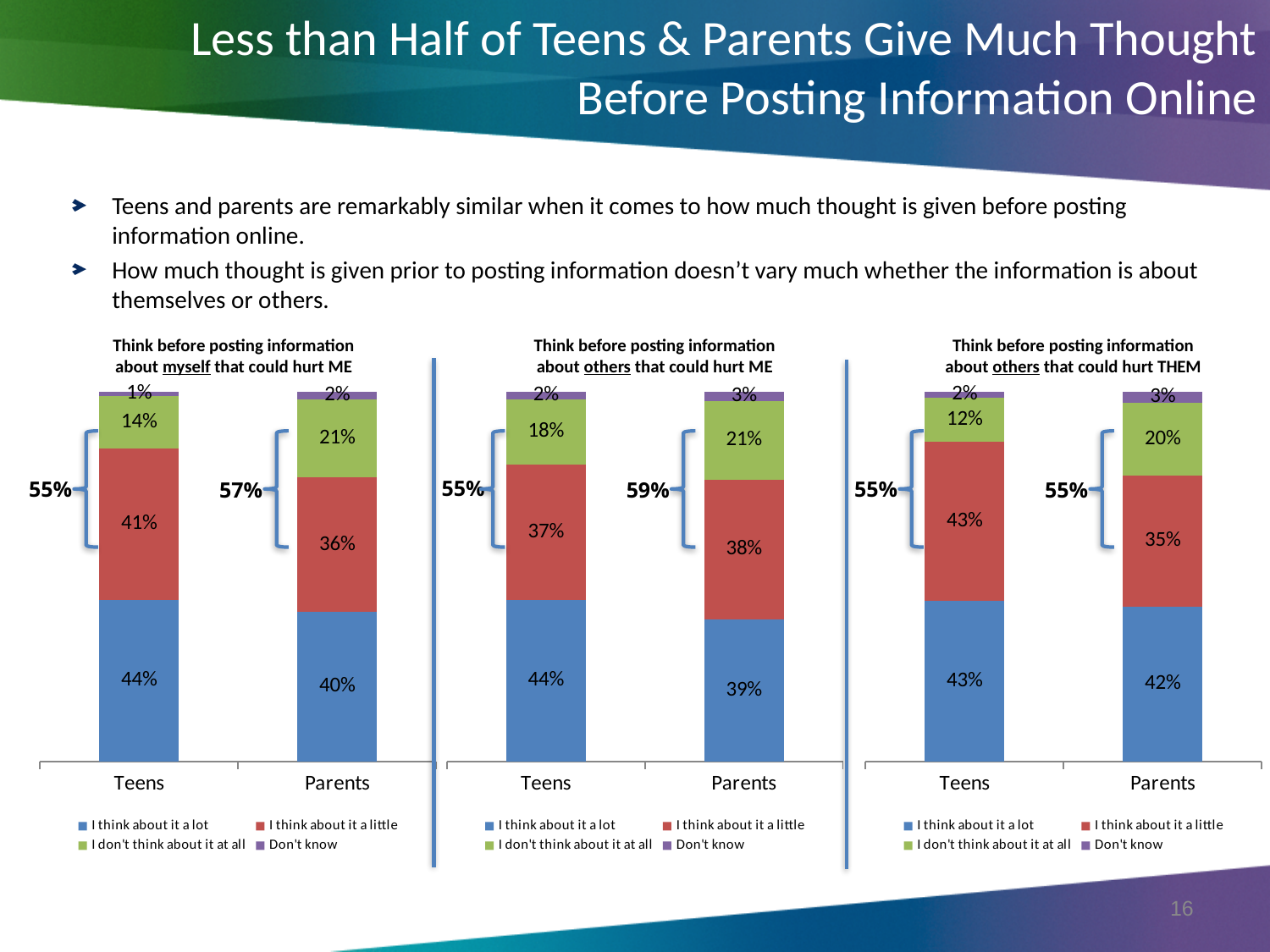
In the chart titled 'Think before posting information about others that could hurt ME', which group has the larger value for 'I don't think about it at all', Teens or Parents? Parents What type of chart is the chart titled 'Think before posting information about others that could hurt ME'? Stacked bar chart How many series does the legend list in the chart titled 'Think before posting information about myself that could hurt ME'? 4 In the chart titled 'Think before posting information about others that could hurt ME', what percentage of Parents say 'I think about it a little'? 38% In the chart titled 'Think before posting information about myself that could hurt ME', what percentage of Teens say 'I think about it a lot'? 44% In the chart titled 'Think before posting information about myself that could hurt ME', what is the difference between the Teens and Parents values for 'I think about it a lot'? 4% In the chart titled 'Think before posting information about others that could hurt THEM', which group has the larger value for 'I think about it a little', Teens or Parents? Teens In the chart titled 'Think before posting information about others that could hurt THEM', what percentage of Teens say 'I don't think about it at all'? 12% In the chart titled 'Think before posting information about others that could hurt THEM', what is the 'Don't know' value for Parents? 3% In the chart titled 'Think before posting information about myself that could hurt ME', what percentage of Parents say 'I don't think about it at all'? 21% In the chart titled 'Think before posting information about others that could hurt ME', what is the combined percentage of Teens who say 'I think about it a little' or 'I don't think about it at all'? 55% How many categories are shown on the x axis of the chart titled 'Think before posting information about others that could hurt THEM'? 2